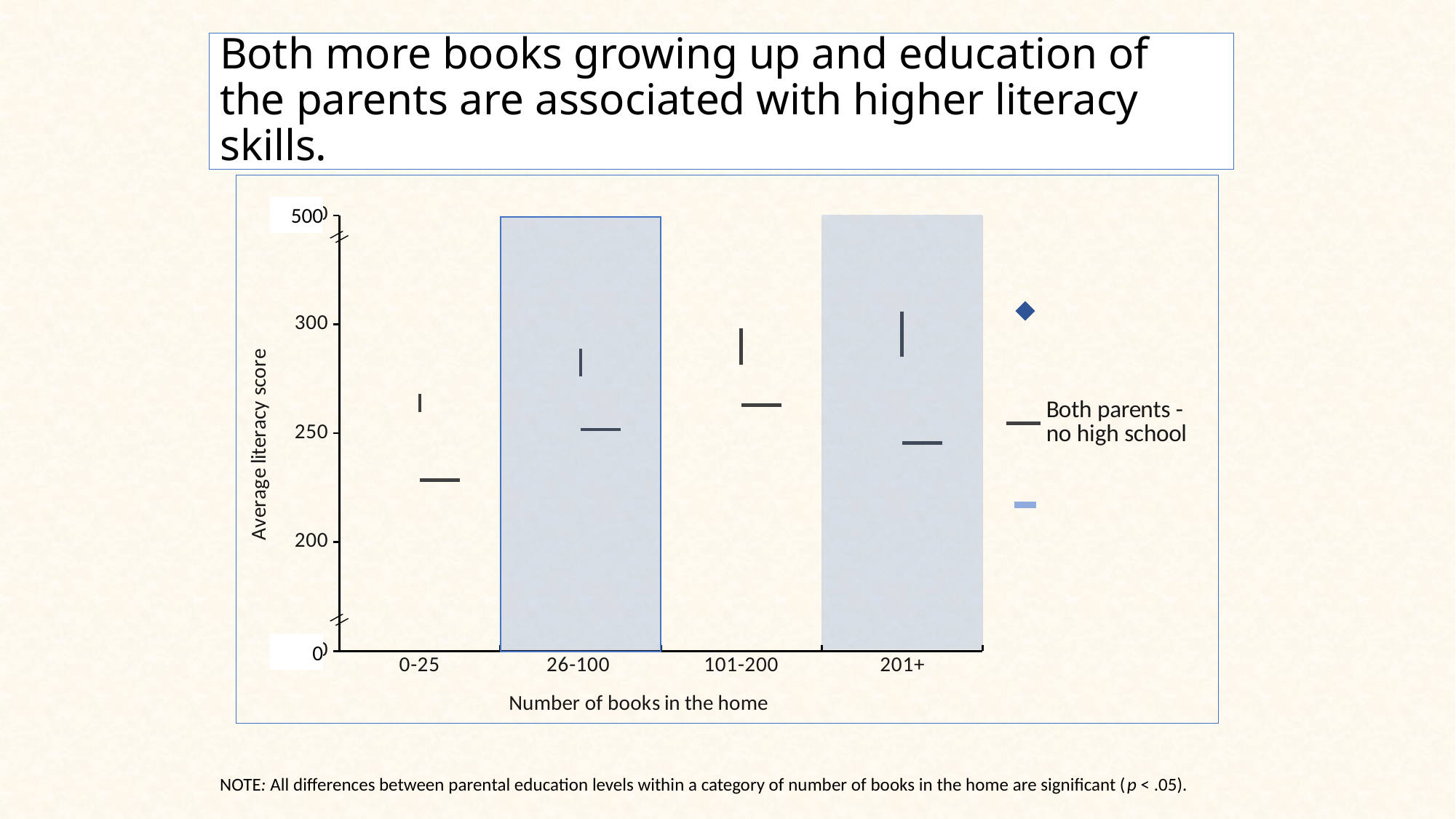
What is the title of the x axis? Number of books in the home Is the 'Both parents - no high school' value for 201+ books greater or less than 300? less Is the 'Both parents - no high school' value for 0-25 books greater or less than 200? greater Is the 'Both parents - no high school' value for 101-200 books greater or less than 250? greater What is the title of the y axis? Average literacy score Which category on the x axis has the highest 'Both parents - no high school' average literacy score? 101-200 How many categories of number of books in the home are shown on the x axis? 4 Does the 'Both parents - no high school' score rise or fall from the 0-25 category to the 101-200 category? rise Which category on the x axis has the lowest 'Both parents - no high school' average literacy score? 0-25 Which has the larger 'Both parents - no high school' score, 0-25 books or 26-100 books? 26-100 Which has the larger 'Both parents - no high school' score, 0-25 books or 101-200 books? 101-200